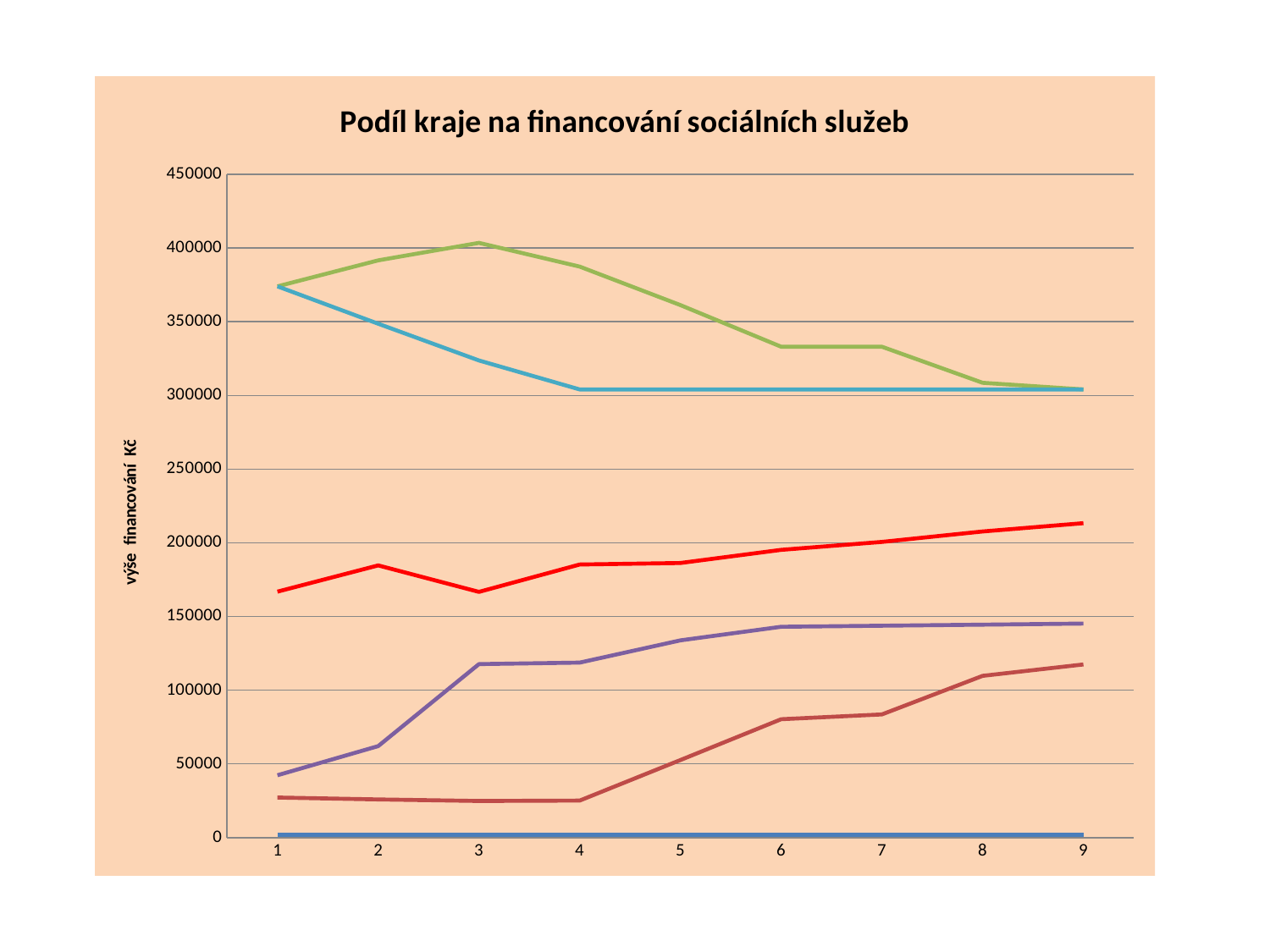
Is the value of the green line at point 1 greater or less than 350000? greater How many lines are plotted on the chart? 6 What is the title of the chart? Podíl kraje na financování sociálních služeb Is the value of the green line at point 6 greater or less than 350000? less What kind of chart is shown on the slide? line chart Does the red line generally rise or fall from point 1 to point 9? rise Is the value of the red line at point 9 greater or less than 200000? greater At point 5, which is larger: the red line or the purple line? the red line How many points are there along the x axis of the chart? 9 Which line has the highest value at point 3? the green line What is the label on the vertical axis of the chart? výše financování Kč